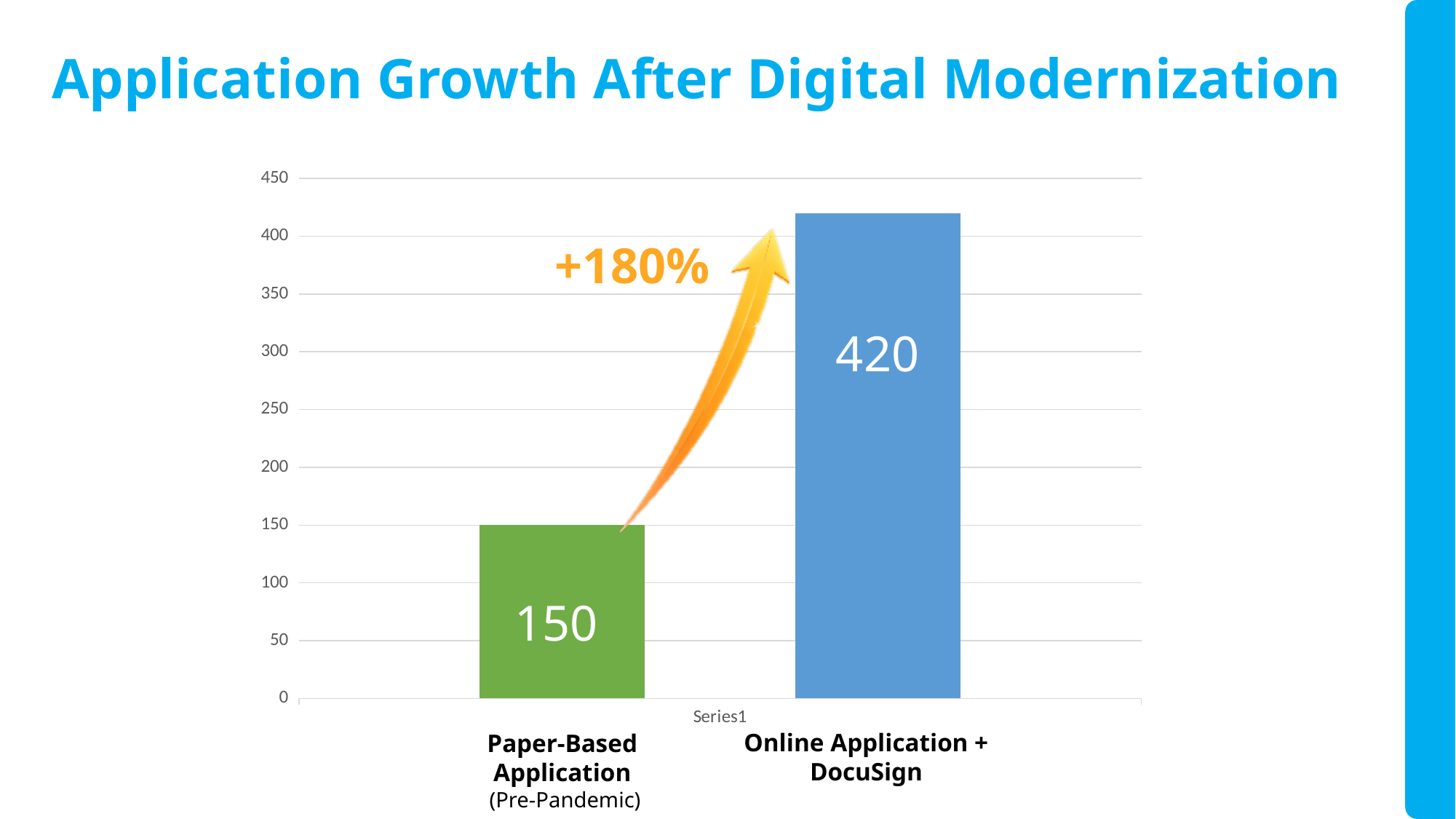
What is the difference between the Online Application + DocuSign value and the Paper-Based Application value? 270 Which category has the highest value? Online Application + DocuSign Is the value for Paper-Based Application greater or less than 200? less Which category has the lowest value? Paper-Based Application (Pre-Pandemic) What is the value for Online Application + DocuSign? 420 What is the value for Paper-Based Application (Pre-Pandemic)? 150 Is the value for Online Application + DocuSign greater or less than 400? greater How many bars are shown in the chart? 2 What is the title of the slide? Application Growth After Digital Modernization Which is larger: the value for Paper-Based Application or the value for Online Application + DocuSign? Online Application + DocuSign What percentage growth is annotated on the chart between the two bars? +180% What kind of chart is shown on the slide? Bar chart